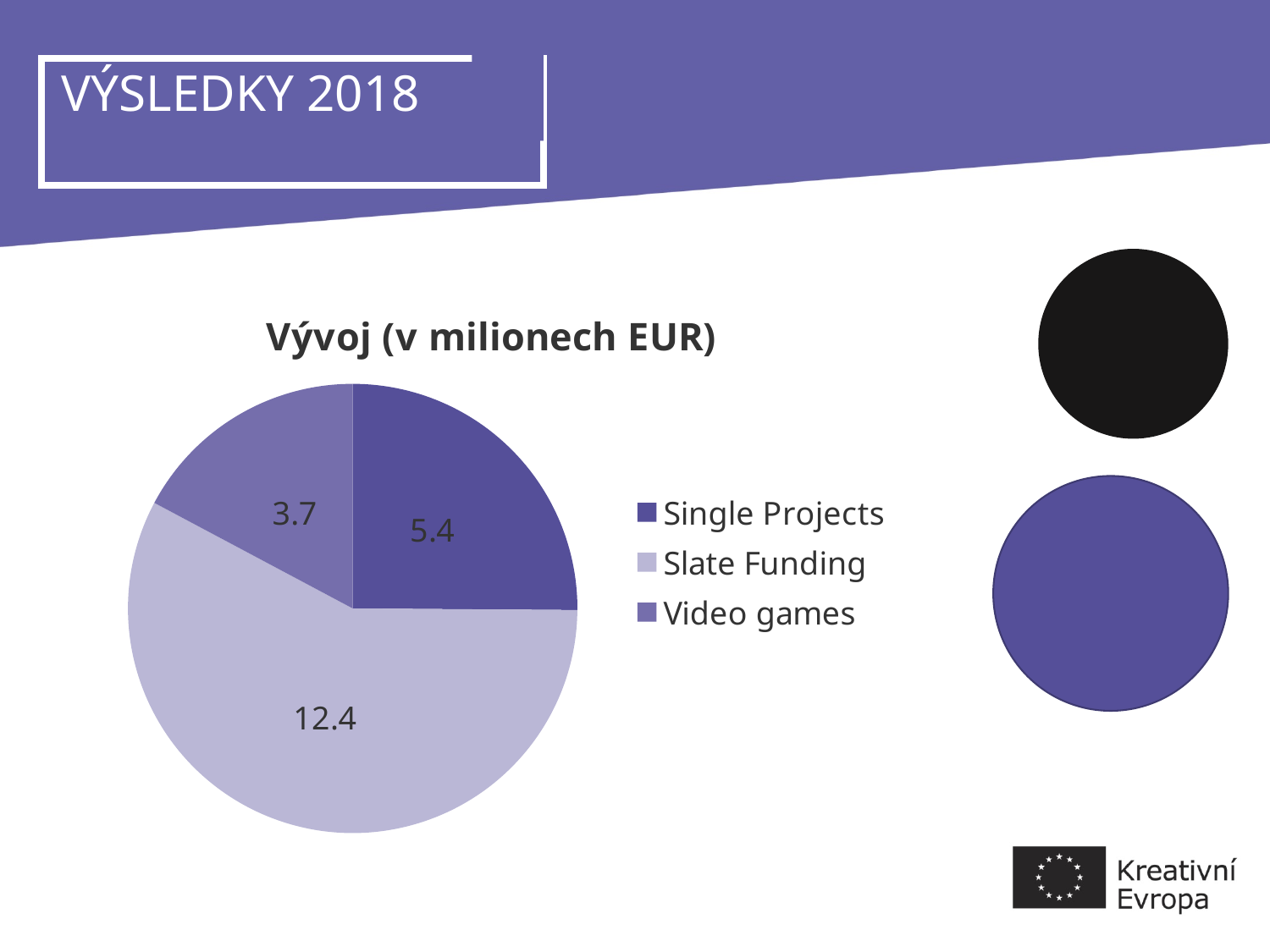
What type of chart is shown on the slide? pie chart What is the value for Slate Funding? 12.4 Which category has the largest slice of the pie? Slate Funding What is the value for Single Projects? 5.4 What is the difference between the values for Slate Funding and Single Projects? 7.0 What is the value for Video games? 3.7 What is the difference between the values for Single Projects and Video games? 1.7 How many categories does the pie chart have? 3 Which is larger, Single Projects or Video games? Single Projects What is the total of all slices in the pie chart? 21.5 What is the title of the chart? Vývoj (v milionech EUR) Which category has the smallest slice of the pie? Video games